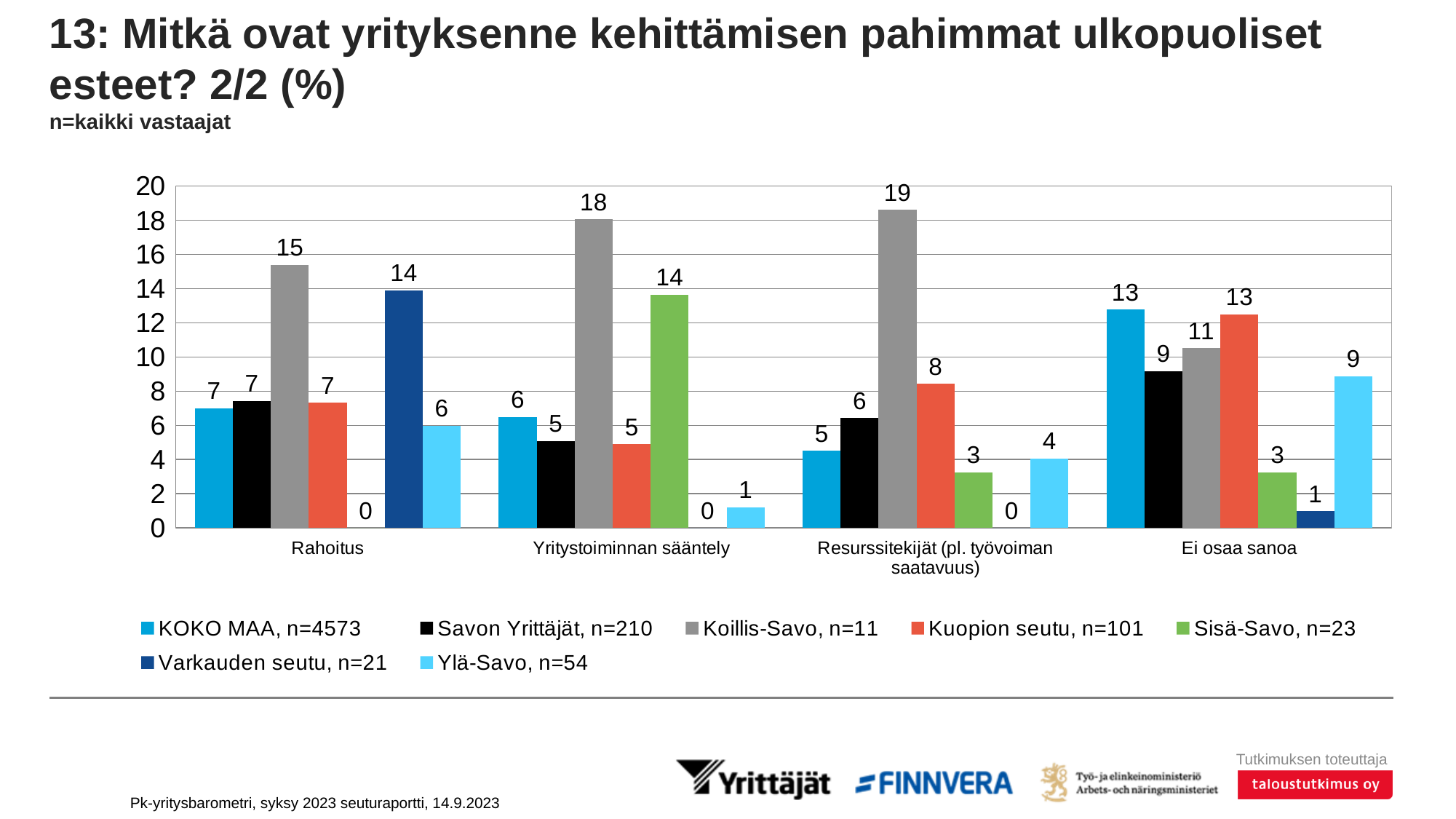
What kind of chart is shown on the slide? Bar chart What is the value for Kuopion seutu, n=101 in the Resurssitekijät (pl. työvoiman saatavuus) category? 8 Which series has the lowest value in the Ei osaa sanoa category? Varkauden seutu, n=21 What is the value for Varkauden seutu, n=21 in the Rahoitus category? 14 Which series has the highest value in the Resurssitekijät (pl. työvoiman saatavuus) category? Koillis-Savo, n=11 What is the value for Sisä-Savo, n=23 in the Yritystoiminnan sääntely category? 14 How many series does the legend list? 7 How many categories are shown on the x axis? 4 What is the value for Koillis-Savo, n=11 in the Rahoitus category? 15 In the Ei osaa sanoa category, which is larger: the value for Savon Yrittäjät, n=210 or the value for Kuopion seutu, n=101? Kuopion seutu, n=101 What is the difference between the Koillis-Savo, n=11 value and the KOKO MAA, n=4573 value in the Yritystoiminnan sääntely category? 12 What is the value for Ylä-Savo, n=54 in the Ei osaa sanoa category? 9